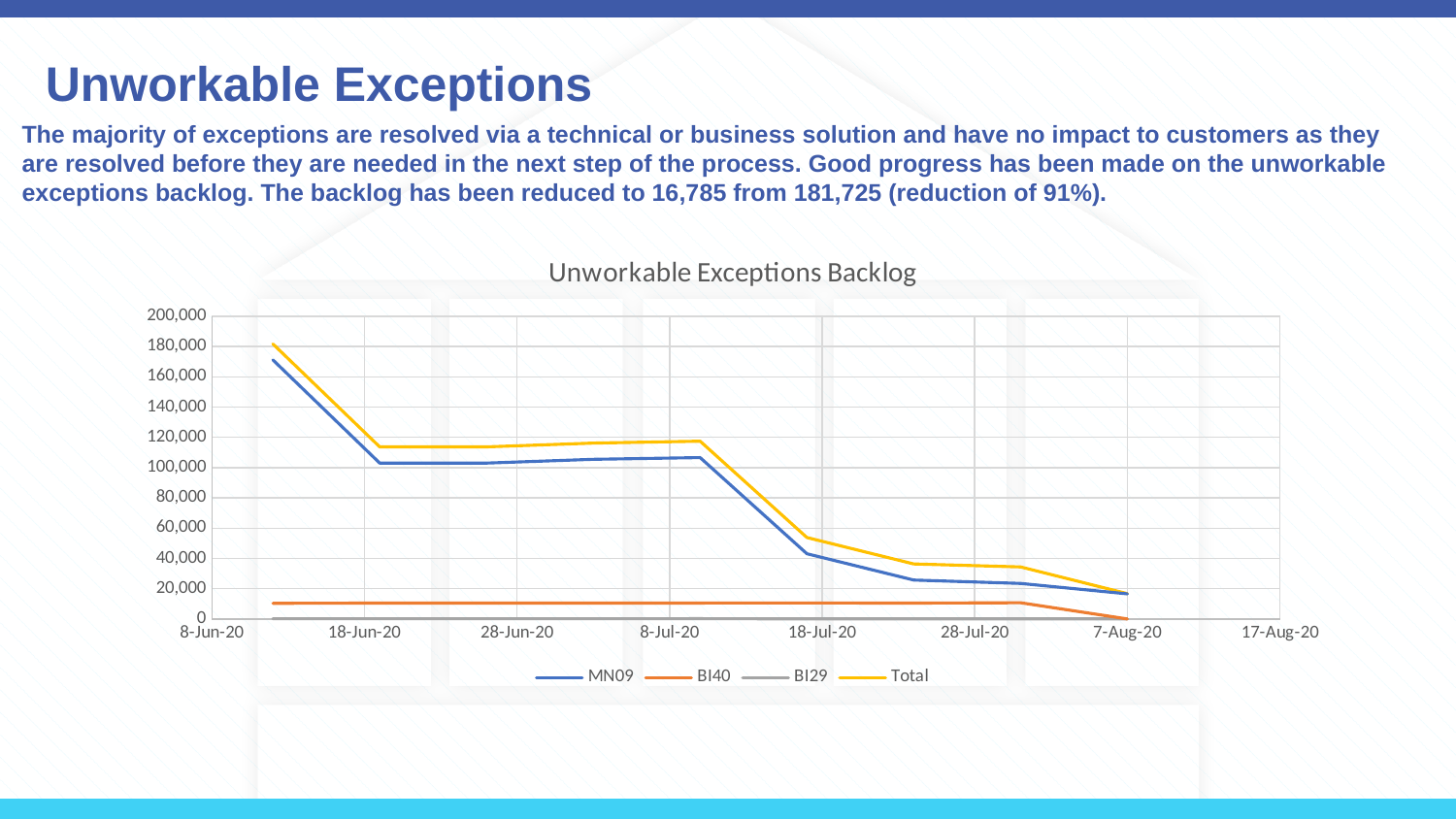
Is the value of the Total series at 18-Jul-20 greater or less than 60,000? less Is the first plotted value of the MN09 series greater or less than 140,000? greater What is the title of the chart? Unworkable Exceptions Backlog At the first plotted point, which series is larger, Total or MN09? Total Which series has the highest values across the chart? Total How many series does the chart legend list? 4 Which series is plotted in yellow? Total Is the value of the MN09 series at 7-Aug-20 greater or less than 20,000? less Which series has the lowest values across the chart? BI29 Does the Total series rise or fall overall from left to right along the x axis? fall What kind of chart is shown on the slide? line chart